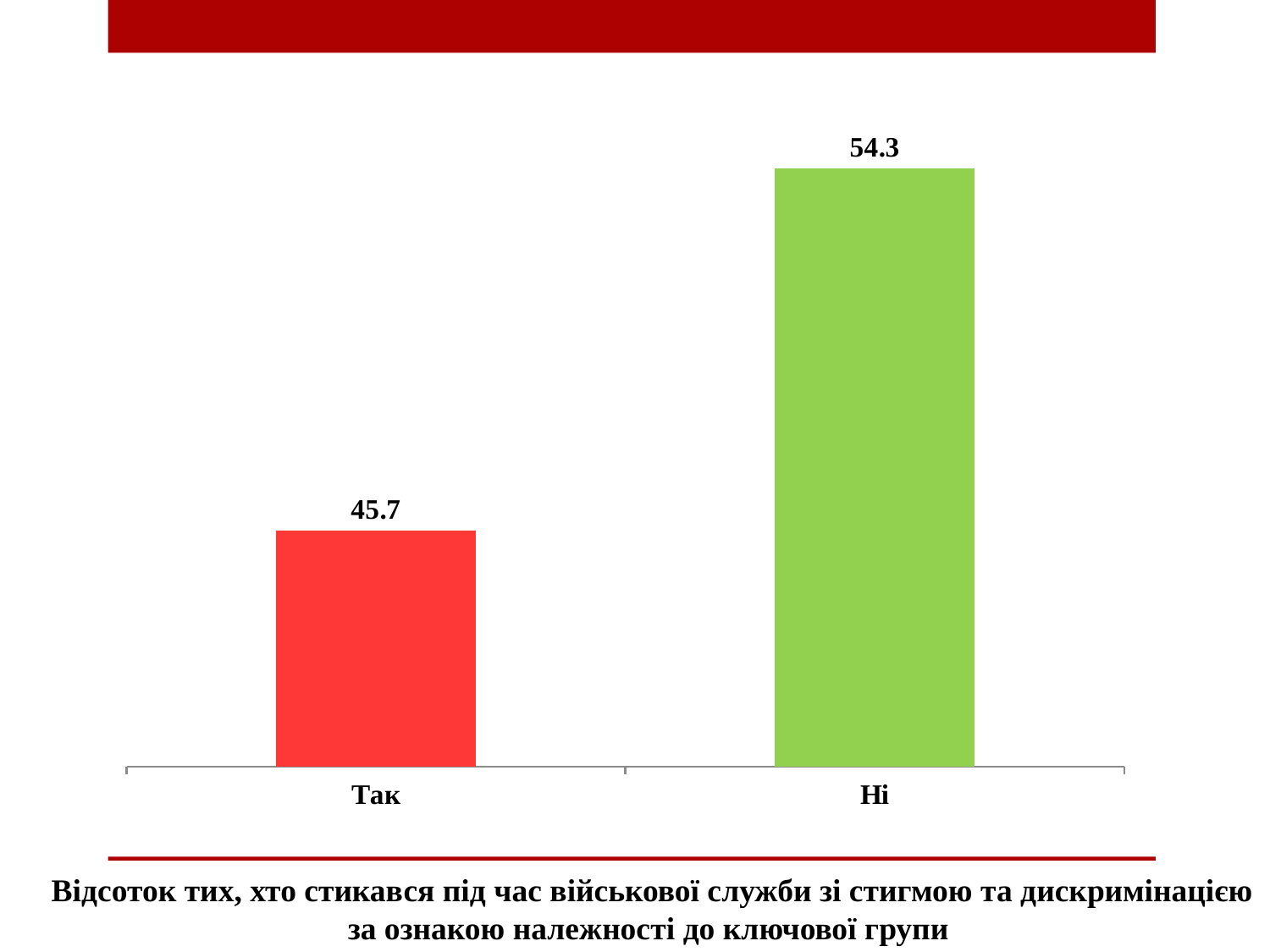
Which category has the highest value? Ні What colour is the "Ні" bar? Green What is the value for the "Так" bar? 45.7 Which category has the lowest value? Так How many categories are shown on the x axis? 2 What colour is the "Так" bar? Red What is the value for the "Ні" bar? 54.3 Which is larger, the value for "Так" or the value for "Ні"? Ні What is the difference between the values for "Ні" and "Так"? 8.6 What is the total of the two bar values? 100 What kind of chart is shown on the slide? Bar chart